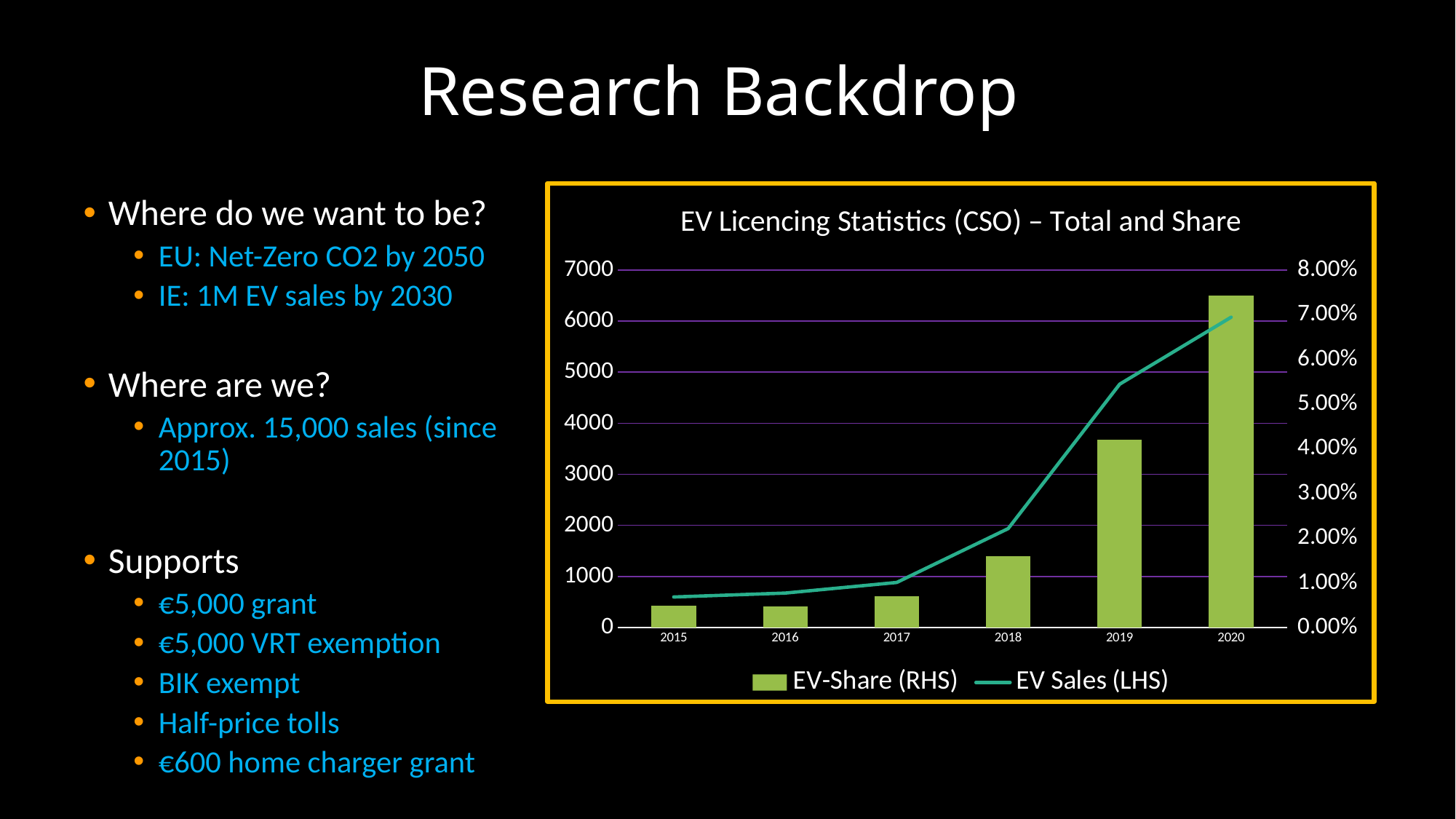
How many years are shown on the x axis of the chart? 6 How many series does the chart legend list? 2 Is the EV Sales (LHS) value for 2020 greater or less than 5000? greater Which series is plotted as a line in the chart? EV Sales (LHS) What is the title of the chart? EV Licencing Statistics (CSO) – Total and Share Which year has the highest EV-Share (RHS) bar? 2020 Is the EV-Share (RHS) value for 2018 greater or less than 2.00%? less Which year has the larger EV-Share (RHS) bar, 2018 or 2019? 2019 Does the EV Sales (LHS) line rise or fall from 2015 to 2020? rise Is the EV Sales (LHS) value for 2015 greater or less than 1000? less